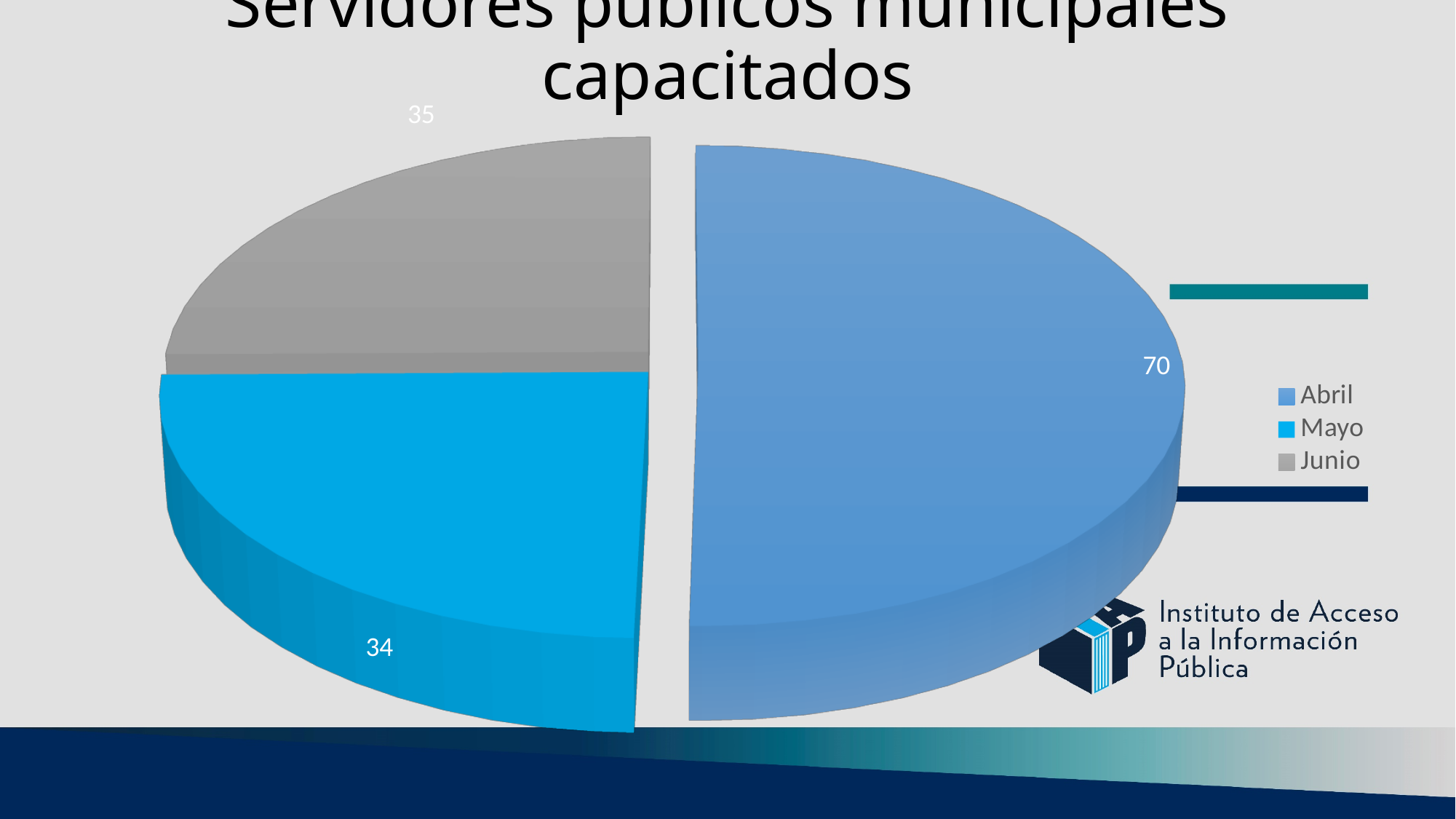
Which is larger, the value for Mayo or the value for Junio? Junio What is the value for Abril? 70 What is the value for Junio? 35 What is the value for Mayo? 34 What is the difference between the values for Abril and Junio? 35 What kind of chart is shown on the slide? Pie chart Which month has the lowest value? Mayo Which month has the highest value? Abril What is the total of all the slices in the pie chart? 139 How many slices does the pie chart have? 3 What is the title of the chart? Servidores públicos municipales capacitados What is the difference between the values for Abril and Mayo? 36